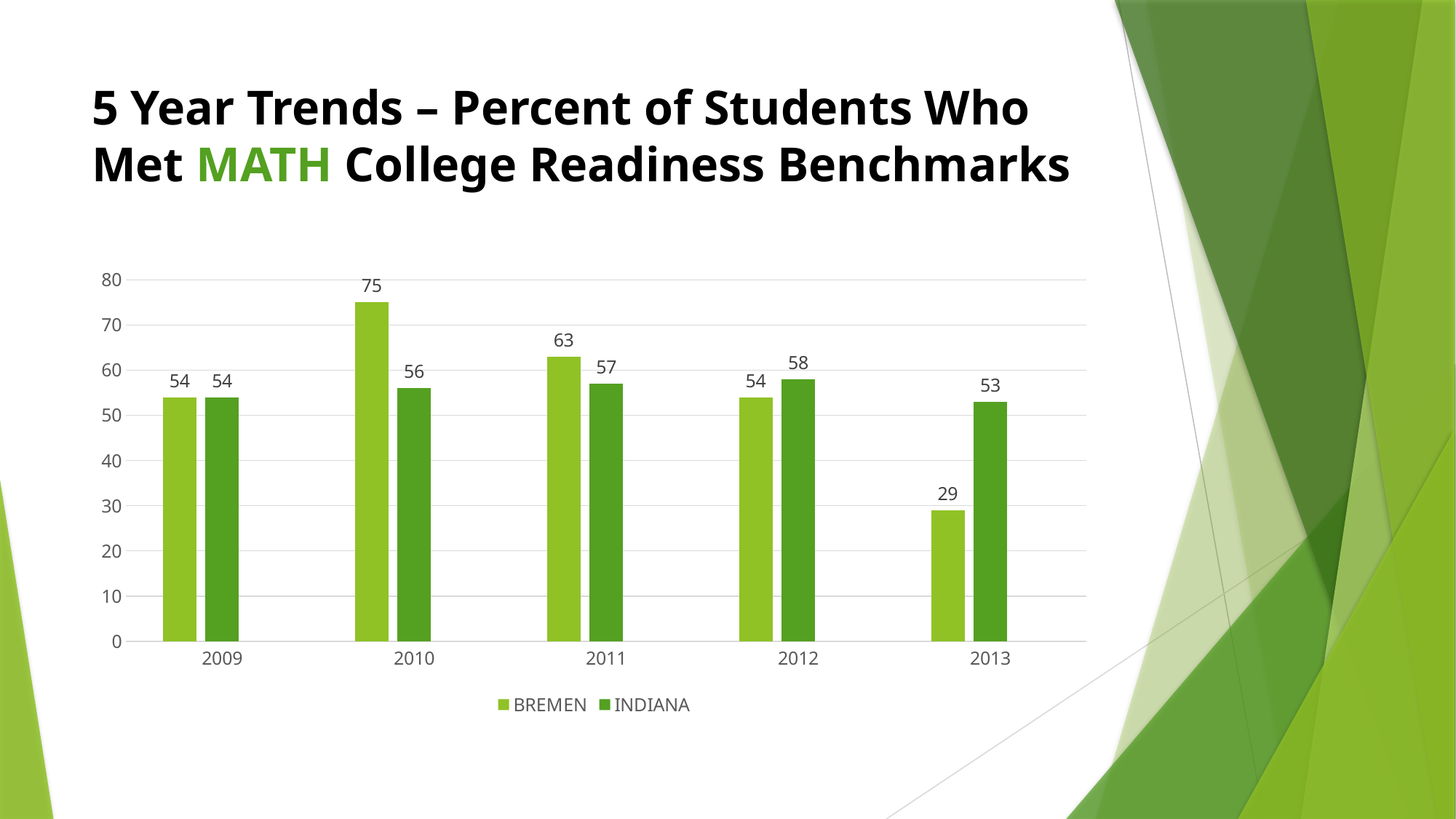
What is the difference between the INDIANA and BREMEN values in 2013? 24 Which is larger in 2011, the BREMEN value or the INDIANA value? BREMEN What is the value for INDIANA in 2013? 53 What is the value for BREMEN in 2010? 75 In which year is the BREMEN value lowest? 2013 In which year is the INDIANA value highest? 2012 What kind of chart is shown on the slide? Bar chart How many years are shown on the x axis? 5 In which year is the BREMEN value highest? 2010 How many series does the legend list? 2 What is the difference between the BREMEN and INDIANA values in 2010? 19 What is the value for BREMEN in 2013? 29